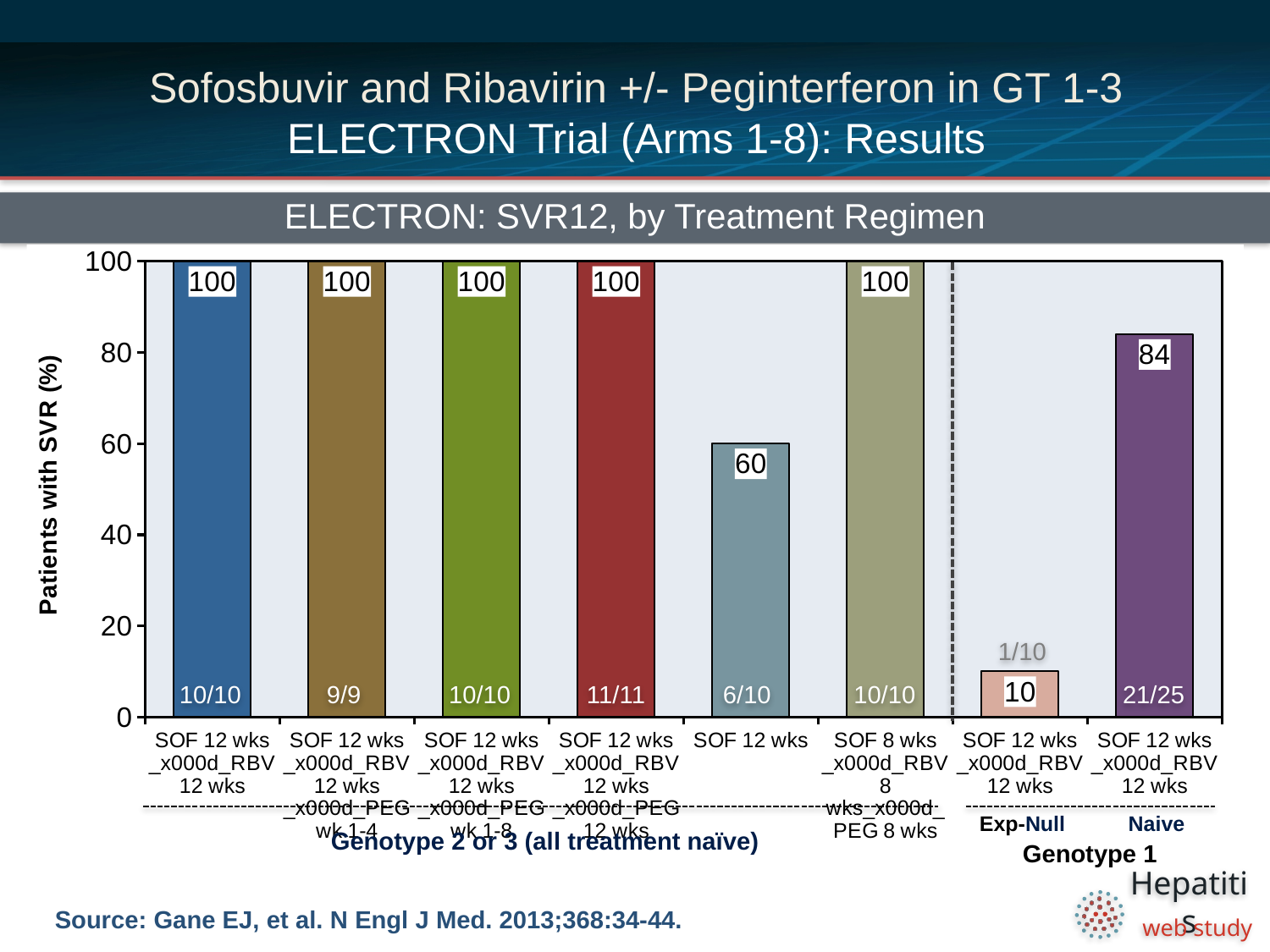
What is the SVR12 value for the Genotype 1 Naive bar? 84 What patient fraction is printed on the Genotype 1 Naive bar? 21/25 Which is larger: the SVR12 for the SOF 12 wks monotherapy bar or the Genotype 1 Naive bar? Genotype 1 Naive What is the title of the y-axis? Patients with SVR (%) How many bars reach an SVR12 value of 100? 5 What is the SVR12 value for the Genotype 1 Exp-Null bar? 10 What is the SVR12 value for the SOF 12 wks monotherapy bar (the fifth bar from the left)? 60 What is the difference in SVR12 between the Genotype 1 Naive bar and the Genotype 1 Exp-Null bar? 74 Which bar has the lowest SVR12 value? Genotype 1 Exp-Null (SOF 12 wks + RBV 12 wks) How many bars are plotted in the chart? 8 What kind of chart is shown on the slide? Bar chart What patient fraction is printed on the SOF 12 wks monotherapy bar (fifth bar)? 6/10